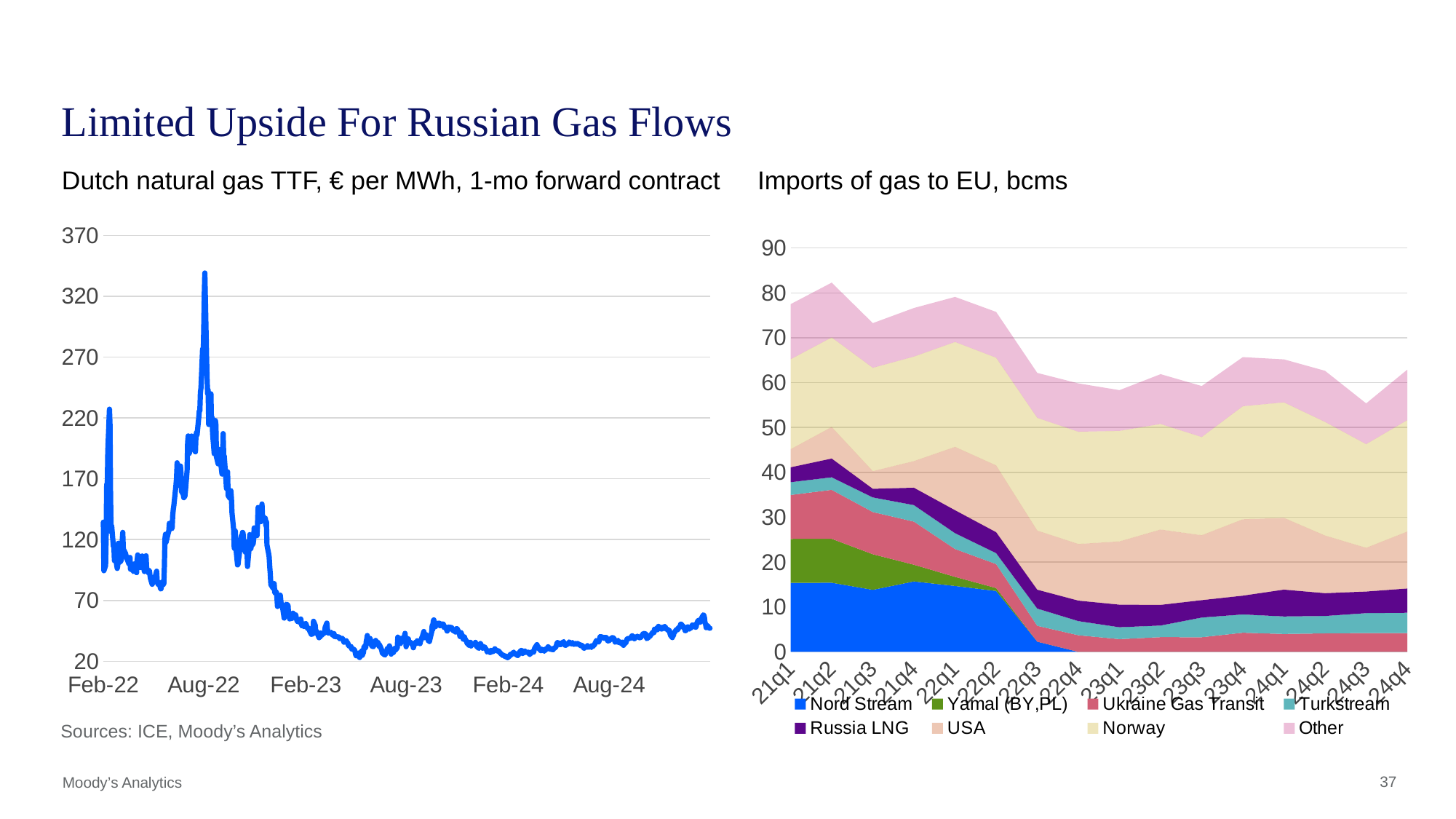
In the right chart 'Imports of gas to EU, bcms', how many series does the legend list? 8 In the right chart 'Imports of gas to EU, bcms', is the Nord Stream value in 21q1 greater or less than 10? greater In the right chart 'Imports of gas to EU, bcms', is the total of all series in 21q2 greater or less than 80? greater In the left chart 'Dutch natural gas TTF', is the peak value reached around Aug-22 greater or less than 320? greater What kind of chart is the left chart, 'Dutch natural gas TTF, € per MWh, 1-mo forward contract'? line chart In the left chart 'Dutch natural gas TTF', does the price rise or fall between Aug-22 and Feb-23? fall In the right chart 'Imports of gas to EU, bcms', how many quarters are labelled on the x axis? 16 What sources are cited for the charts on the slide? ICE, Moody's Analytics What kind of chart is the right chart, 'Imports of gas to EU, bcms'? stacked area chart In the right chart 'Imports of gas to EU, bcms', which series is plotted at the bottom of the stack? Nord Stream